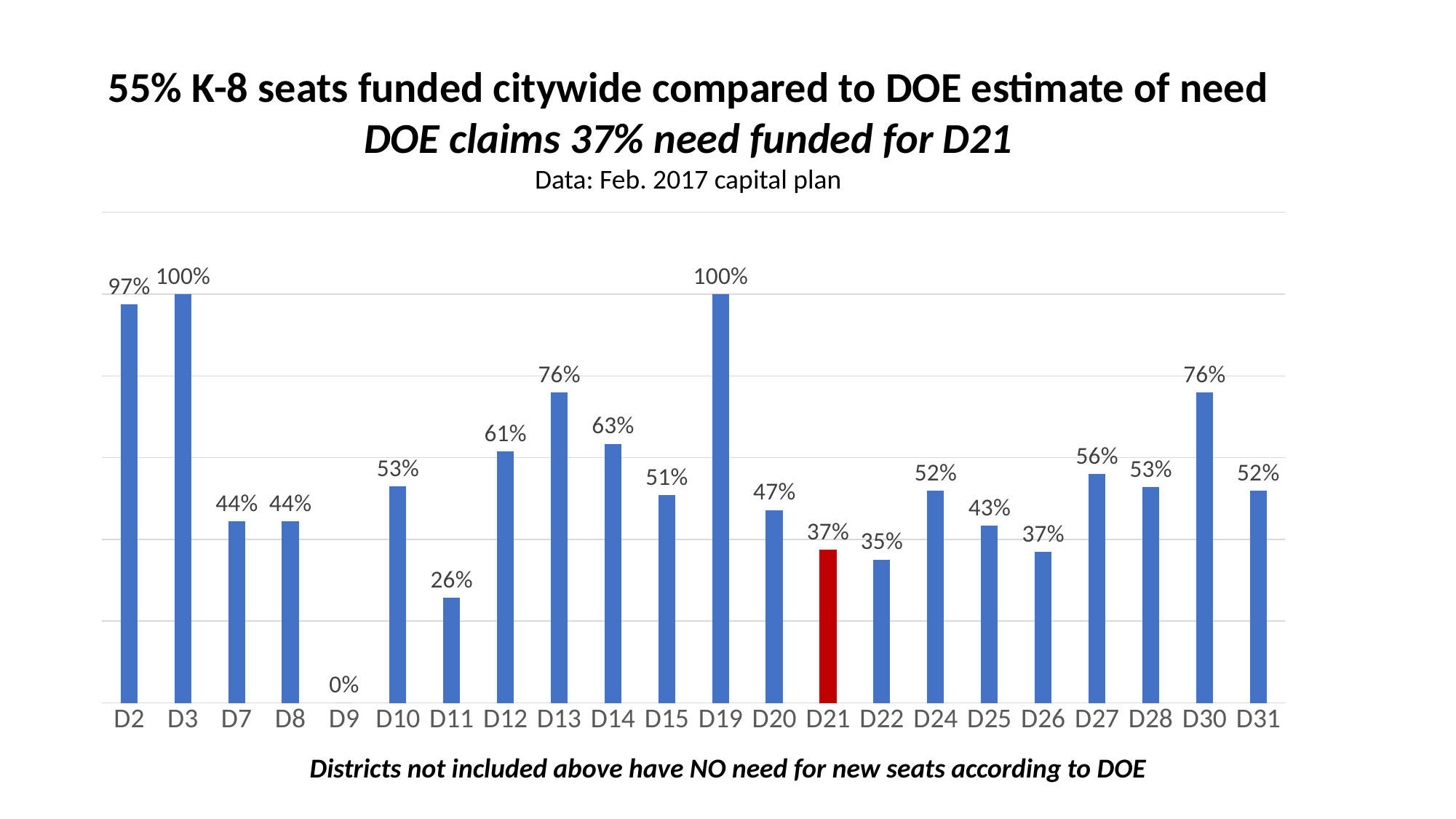
What kind of chart is shown on the slide? Bar chart Which has a larger value, D12 or D14? D14 Which two districts share the highest value of 100%? D3 and D19 What percentage of K-8 seat need is funded for D21? 37% What is the value shown for D11? 26% How many districts are shown on the chart? 22 Which district has the lowest value on the chart? D9 Which district's bar is coloured red instead of blue? D21 What is the value shown for D13? 76% What is the difference between the values for D30 and D31? 24% Which has a larger value, D22 or D25? D25 What is the difference between the values for D2 and D21? 60%